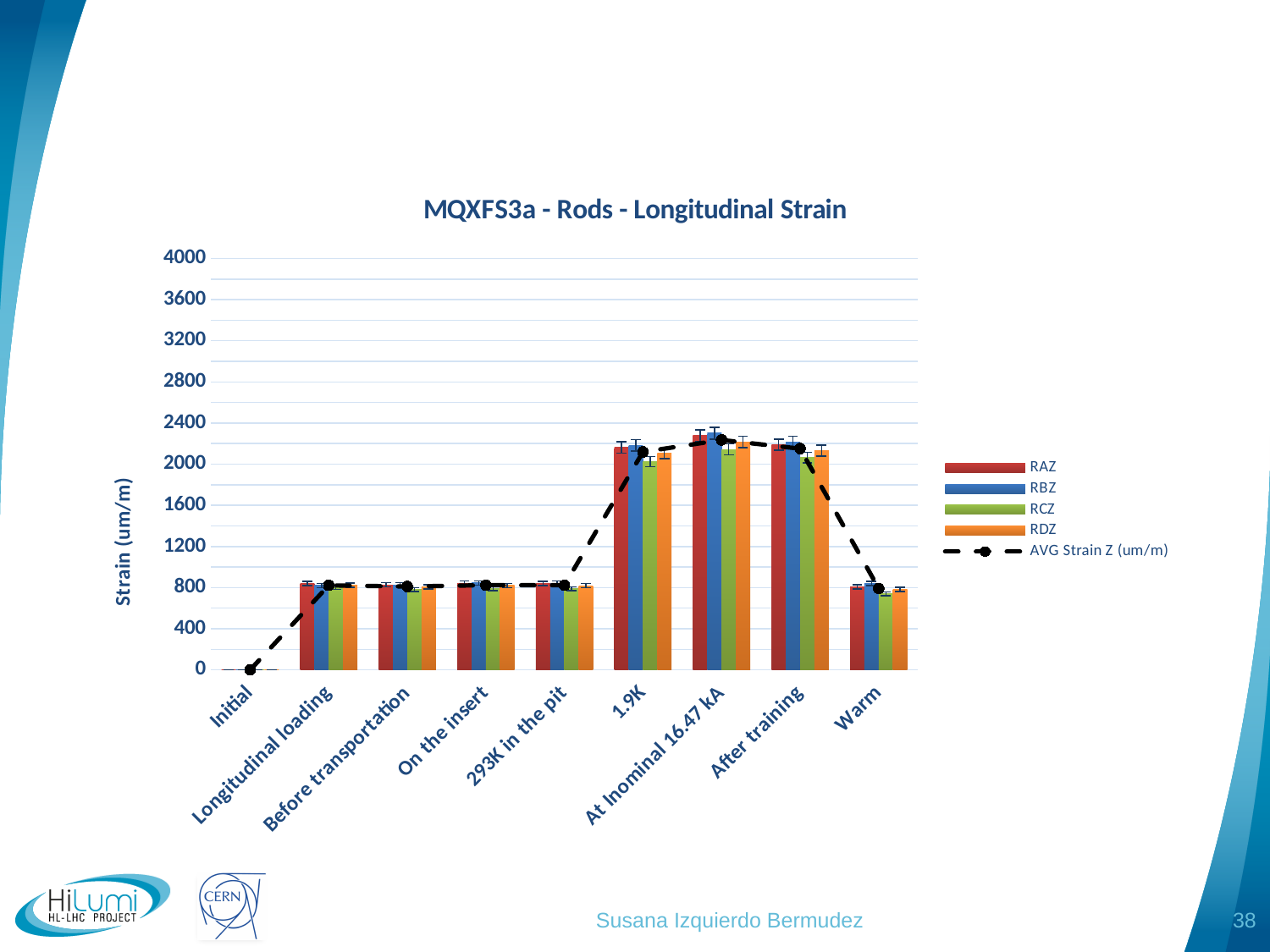
Do the values rise or fall from After training to Warm? fall Is the RAZ value at At Inominal 16.47 kA greater or less than 2000? greater Is the RCZ value at Warm greater or less than 800? less Which is larger, the RAZ value at 1.9K or the RAZ value at Warm? 1.9K What is the title of the chart? MQXFS3a - Rods - Longitudinal Strain How many categories are shown along the x axis? 9 How many entries does the legend list? 5 At which category is the RAZ value lowest? Initial Is the RAZ value at 1.9K greater or less than 2000? greater What is the label of the vertical axis? Strain (um/m) What kind of chart is shown on the slide? combination bar and line chart